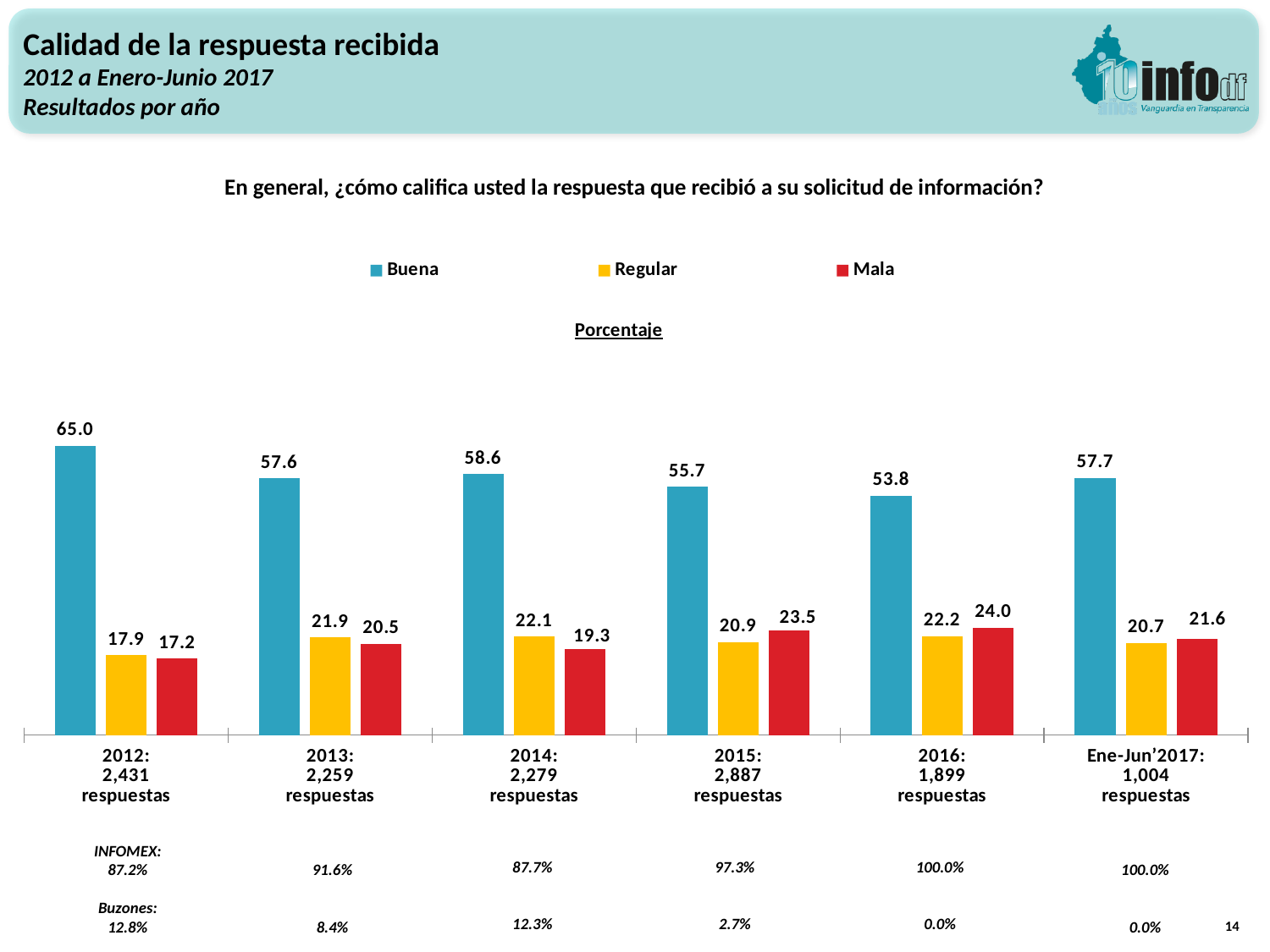
What is the value for Mala in 2016? 24.0 Which colour represents the Buena series in the legend? blue How many year categories are shown on the x axis? 6 What is the value for Regular in Ene-Jun'2017? 20.7 What is the difference between the Mala values for 2016 and 2012? 6.8 What is the value for Buena in 2012? 65.0 What is the difference between the Buena values for 2012 and 2013? 7.4 In which year is the Buena value highest? 2012 In which year is the Buena value lowest? 2016 How many series does the legend list? 3 What kind of chart is shown on the slide? bar chart Which is larger in 2015, Regular or Mala? Mala